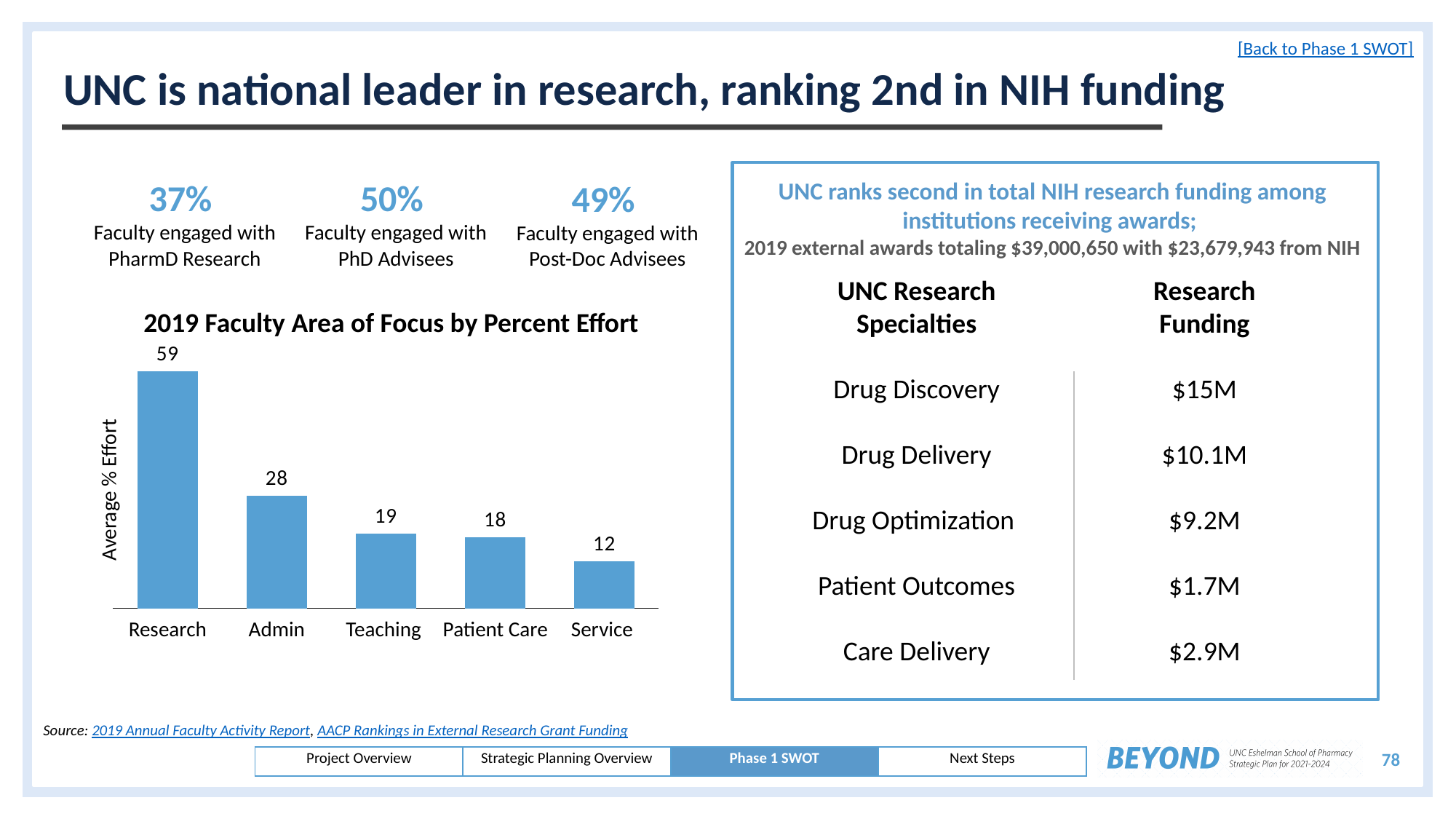
Which category has the highest average % effort in the 2019 Faculty Area of Focus by Percent Effort chart? Research What is the value for Research in the 2019 Faculty Area of Focus by Percent Effort chart? 59 Which category has the lowest average % effort in the 2019 Faculty Area of Focus by Percent Effort chart? Service In the 2019 Faculty Area of Focus by Percent Effort chart, which is larger, the value for Admin or the value for Teaching? Admin What kind of chart is the 2019 Faculty Area of Focus by Percent Effort chart? Bar chart What is the value for Teaching in the 2019 Faculty Area of Focus by Percent Effort chart? 19 What is the value for Service in the 2019 Faculty Area of Focus by Percent Effort chart? 12 How many categories are shown in the 2019 Faculty Area of Focus by Percent Effort chart? 5 What is the value for Admin in the 2019 Faculty Area of Focus by Percent Effort chart? 28 What is the y-axis label of the 2019 Faculty Area of Focus by Percent Effort chart? Average % Effort What is the difference between the values for Patient Care and Service in the 2019 Faculty Area of Focus by Percent Effort chart? 6 What is the difference between the values for Research and Admin in the 2019 Faculty Area of Focus by Percent Effort chart? 31